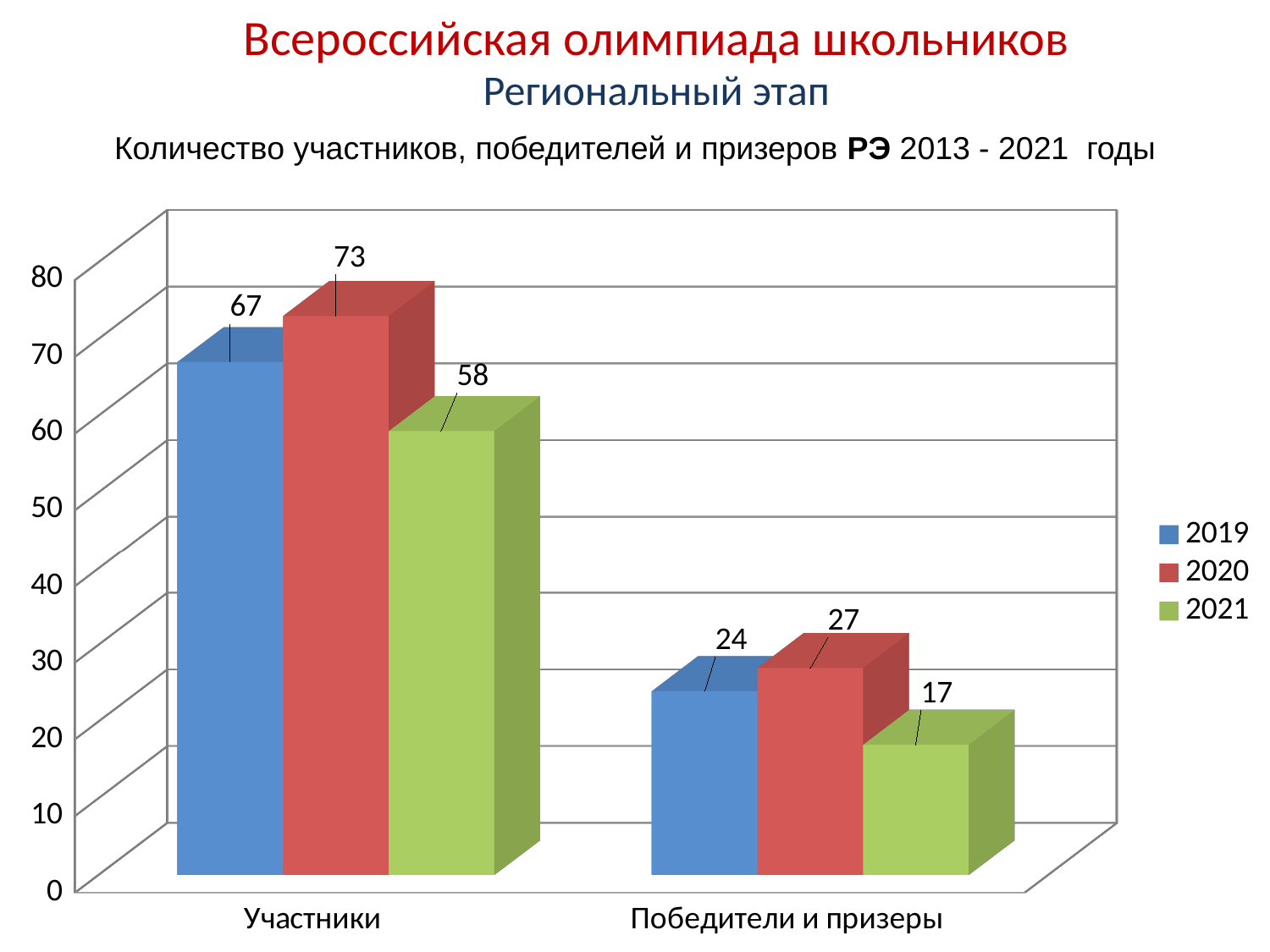
How many categories are shown on the x axis? 2 How many series does the legend list? 3 What kind of chart is shown on the slide? bar chart What is the difference between the 2020 and 2021 values in the Участники category? 15 Is the 2021 value for Победители и призеры greater or less than 20? less Which year has the lowest value in the Победители и призеры category? 2021 What is the value for 2019 in the Участники category? 67 What is the difference between the 2019 and 2020 values in the Победители и призеры category? 3 Which is larger: the 2019 value for Участники or the 2021 value for Участники? 2019 Which year has the highest value in the Участники category? 2020 What is the value for 2020 in the Участники category? 73 What is the value for 2021 in the Победители и призеры category? 17